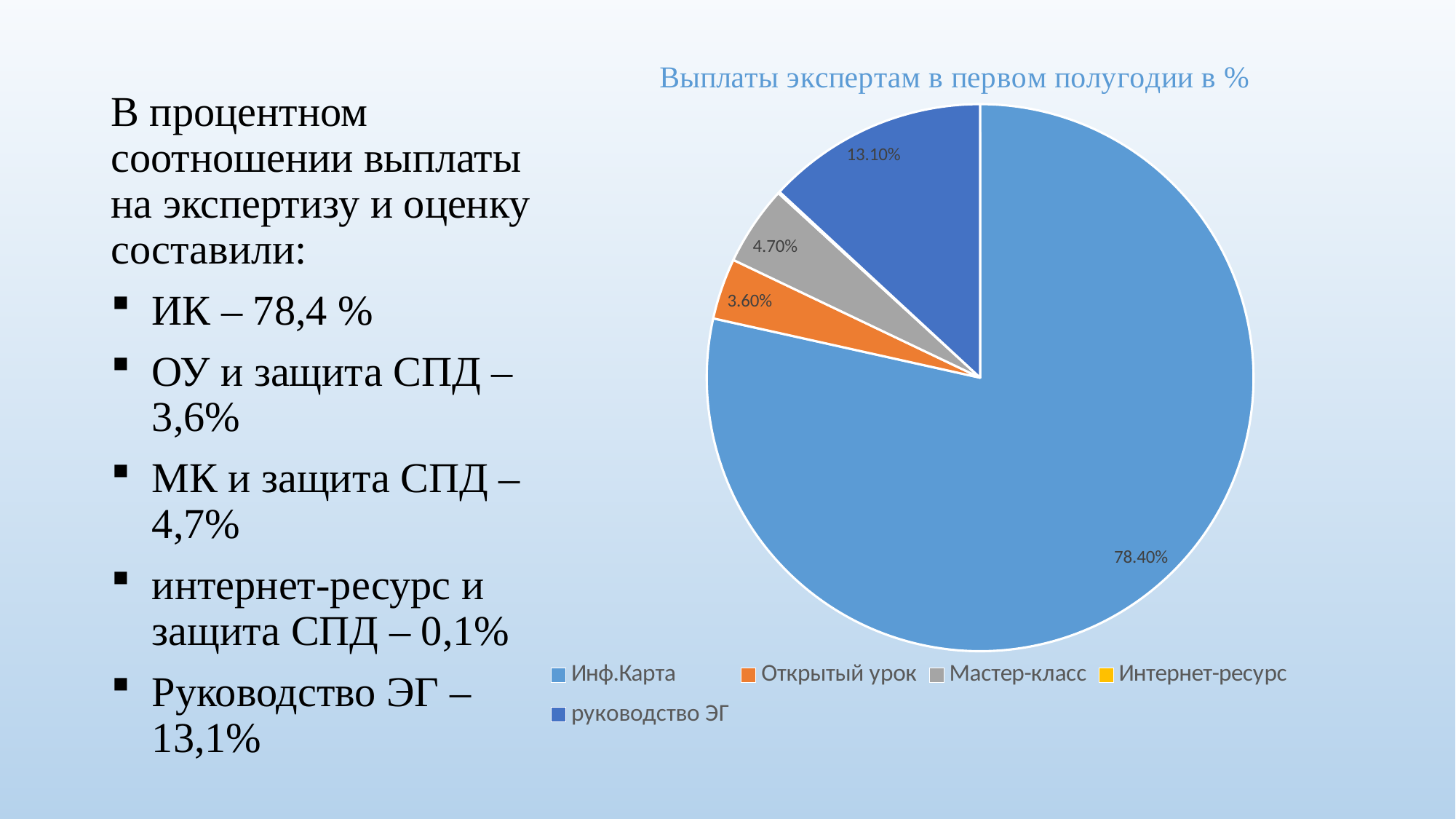
How many categories does the legend list? 5 What is the difference between the руководство ЭГ slice and the Мастер-класс slice? 8.40% Which is larger, the Мастер-класс slice or the Открытый урок slice? Мастер-класс What is the title of the chart? Выплаты экспертам в первом полугодии в % What type of chart is shown on the slide? Pie chart What percentage does the Открытый урок slice show? 3.60% What percentage does the руководство ЭГ slice show? 13.10% What colour is the Открытый урок slice? Orange Which category has the largest slice of the pie? Инф.Карта What percentage does the Мастер-класс slice show? 4.70% What is the difference between the Инф.Карта slice and the руководство ЭГ slice? 65.30% What percentage does the Инф.Карта slice show? 78.40%